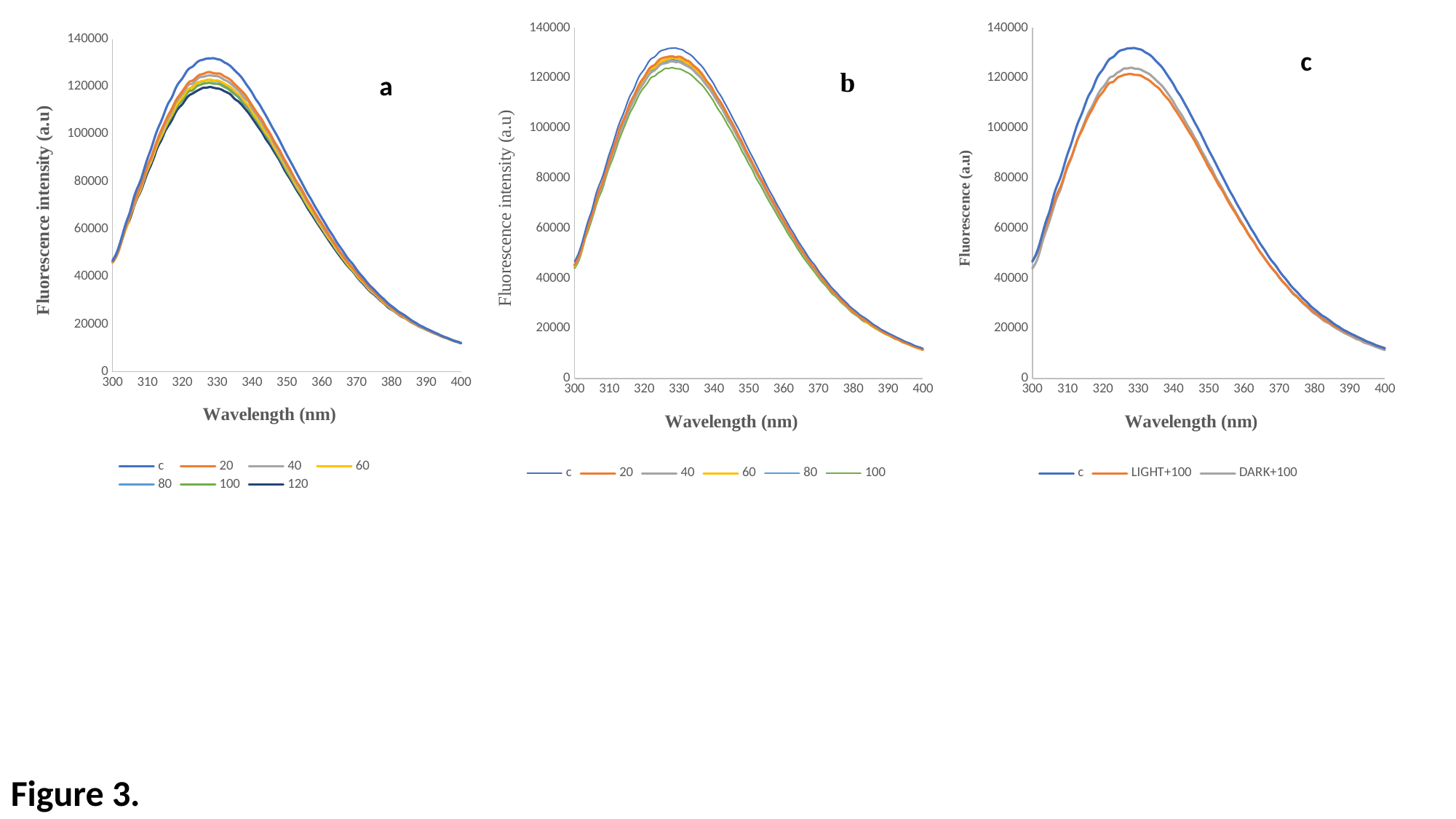
In chart c, which series reaches the highest peak fluorescence? c What kind of chart is chart a? line chart In chart c, do the values rise or fall along the x axis from 330 nm to 400 nm? fall How many series does the legend of chart c list? 3 In chart a, which series reaches the highest peak fluorescence intensity? c In chart b, which series has the lowest peak fluorescence intensity? 100 What is the x-axis title of chart b? Wavelength (nm) How many series does the legend of chart b list? 6 How many series does the legend of chart a list? 7 In chart a, is the value of series c at 400 nm greater or less than 20000? less In chart c, which series has the lowest peak fluorescence? LIGHT+100 In chart b, is the peak value of series c greater or less than 120000? greater